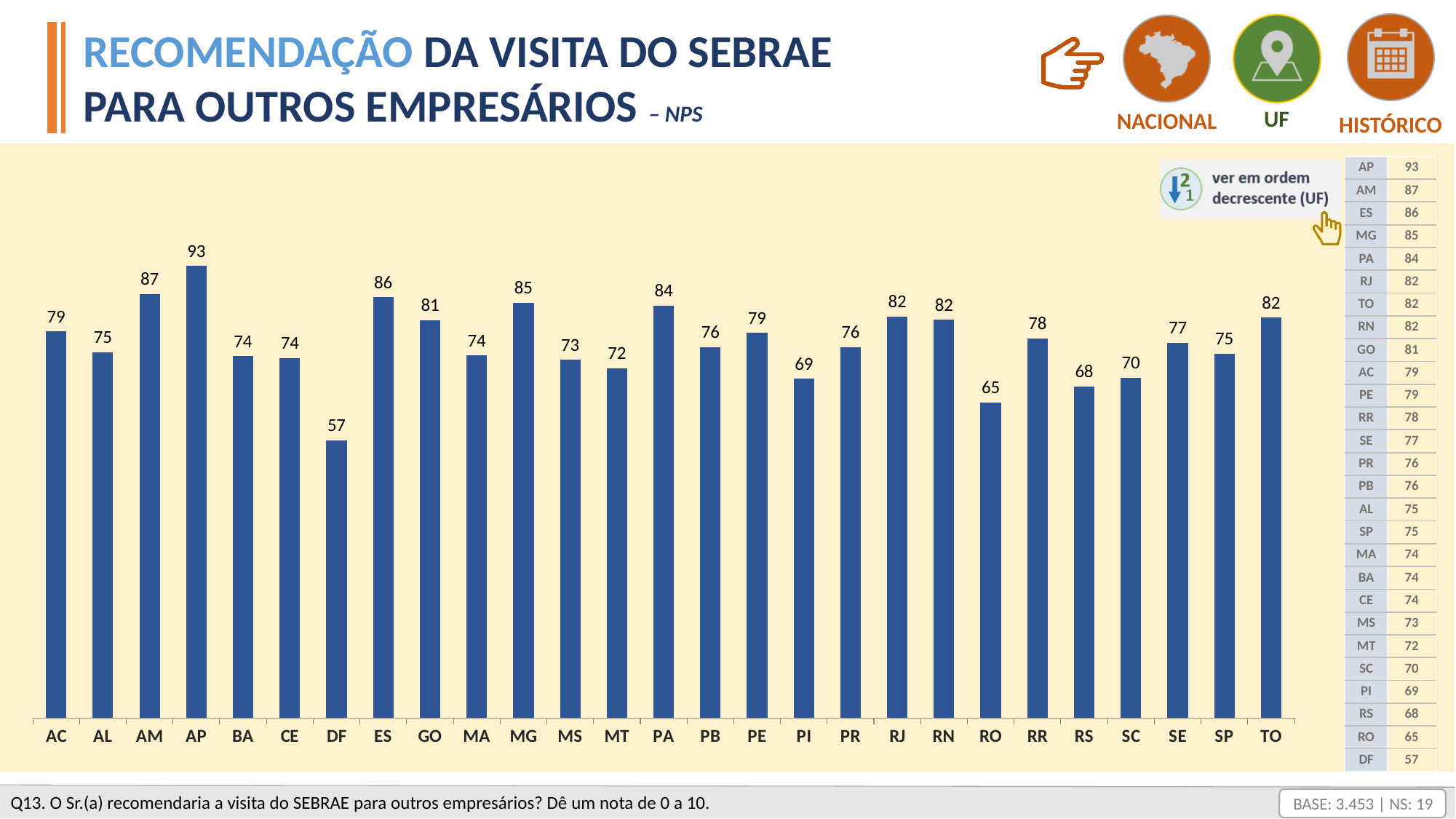
Which UF has the highest NPS value? AP Which UF has the lowest NPS value? DF What is the NPS value for AP? 93 What is the difference between the NPS values for AP and DF? 36 What type of chart is shown on the slide? Bar chart What is the difference between the NPS values for AM and RO? 22 What is the NPS value for RS? 68 Which has a higher NPS value, ES or GO? ES How many UFs (categories) are shown in the bar chart? 27 What is the NPS value for MG? 85 What is the NPS value for DF? 57 Which has a higher NPS value, PI or SC? SC